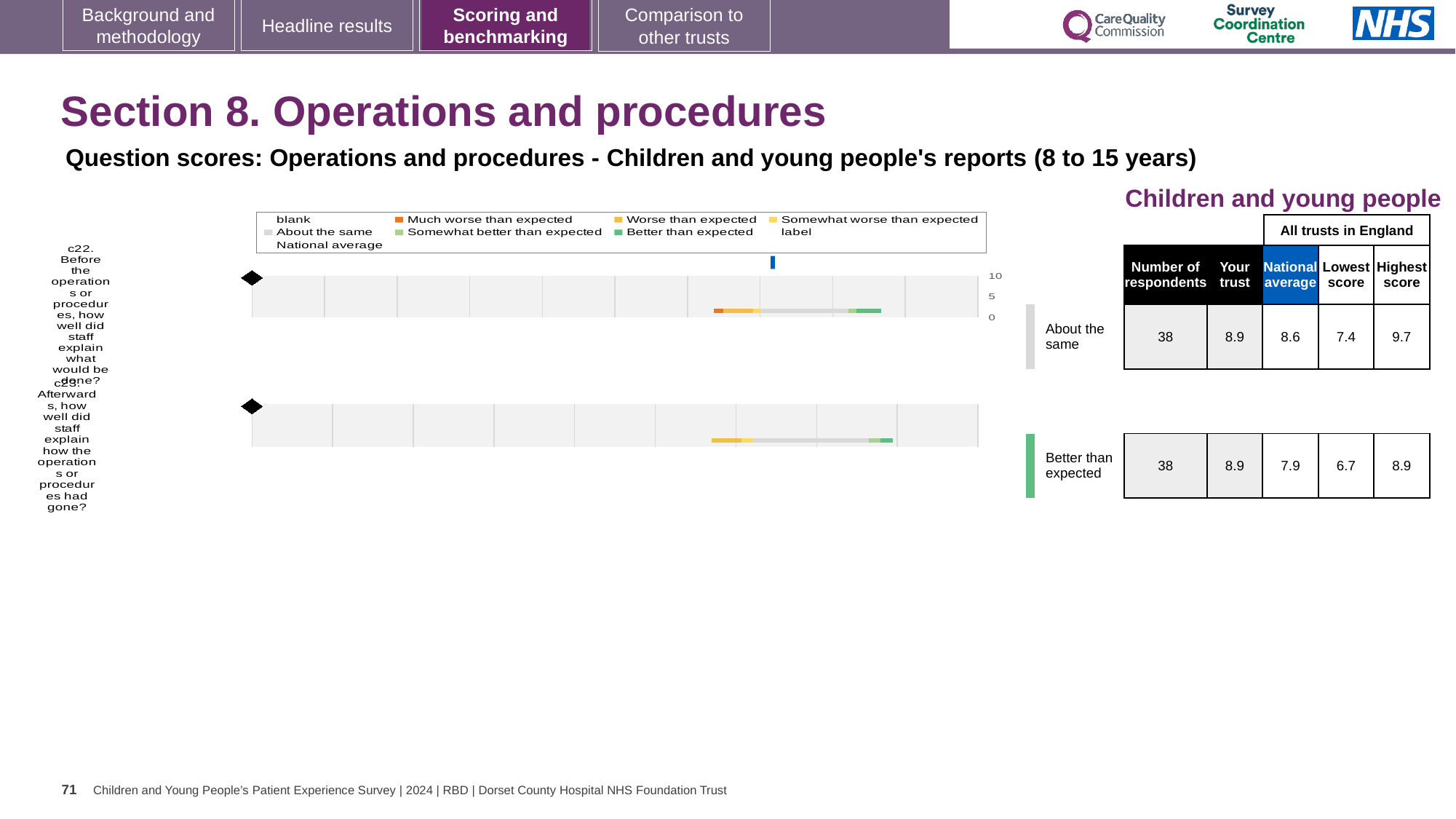
How many entries does the chart legend list? 9 For question c22, which is higher: the trust's score or the national average? Your trust What is the national average score for question c22? 8.6 How many survey questions are plotted in the benchmarking charts on this slide? 2 What is the highest score among all trusts in England for question c23? 8.9 Which benchmarking category is the trust's result for question c23 placed in? Better than expected What is the lowest score among all trusts in England for question c22? 7.4 What is the 'Your trust' score for question c22 (Before the operations or procedures, how well did staff explain what would be done?)? 8.9 For question c23, what is the difference between the trust's score (8.9) and the national average (7.9)? 1.0 What is the highest tick value shown on the chart's score axis? 10 How many respondents answered question c23 (Afterwards, how well did staff explain how the operations or procedures had gone?)? 38 What kind of chart is used to show the question scores for c22 and c23? Bar chart